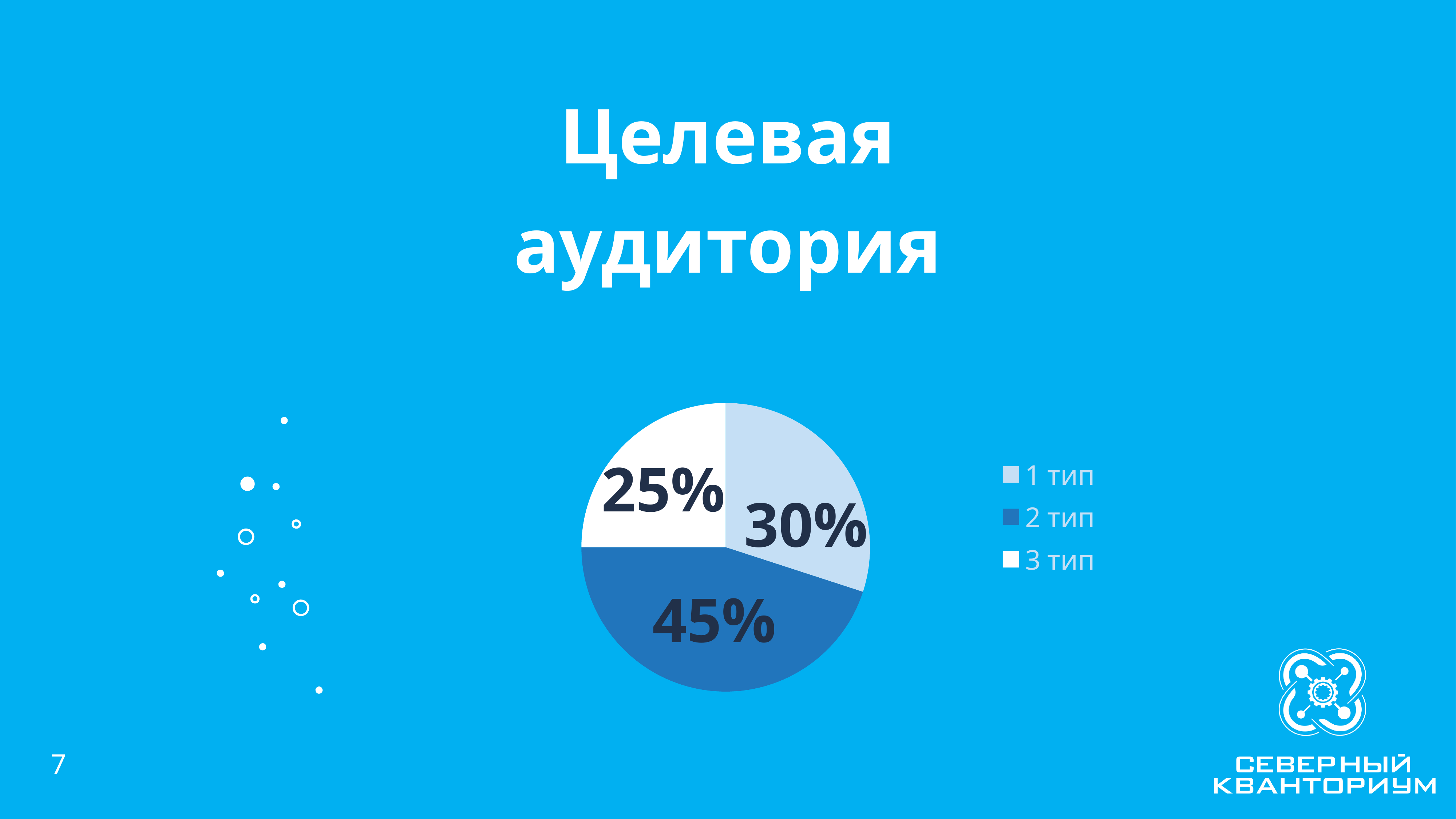
Which category has the smallest slice of the pie? 3 тип What is the difference in percentage points between 2 тип and 3 тип? 20 How many slices does the pie chart have? 3 How many entries does the legend list? 3 What share of the pie does 1 тип have? 30% Which legend entry is shown in white? 3 тип Which is larger, the slice for 1 тип or the slice for 2 тип? 2 тип What is the difference in percentage points between 1 тип and 3 тип? 5 Which category has the largest slice of the pie? 2 тип What share of the pie does 2 тип have? 45% What share of the pie does 3 тип have? 25% What kind of chart is shown on the slide? Pie chart